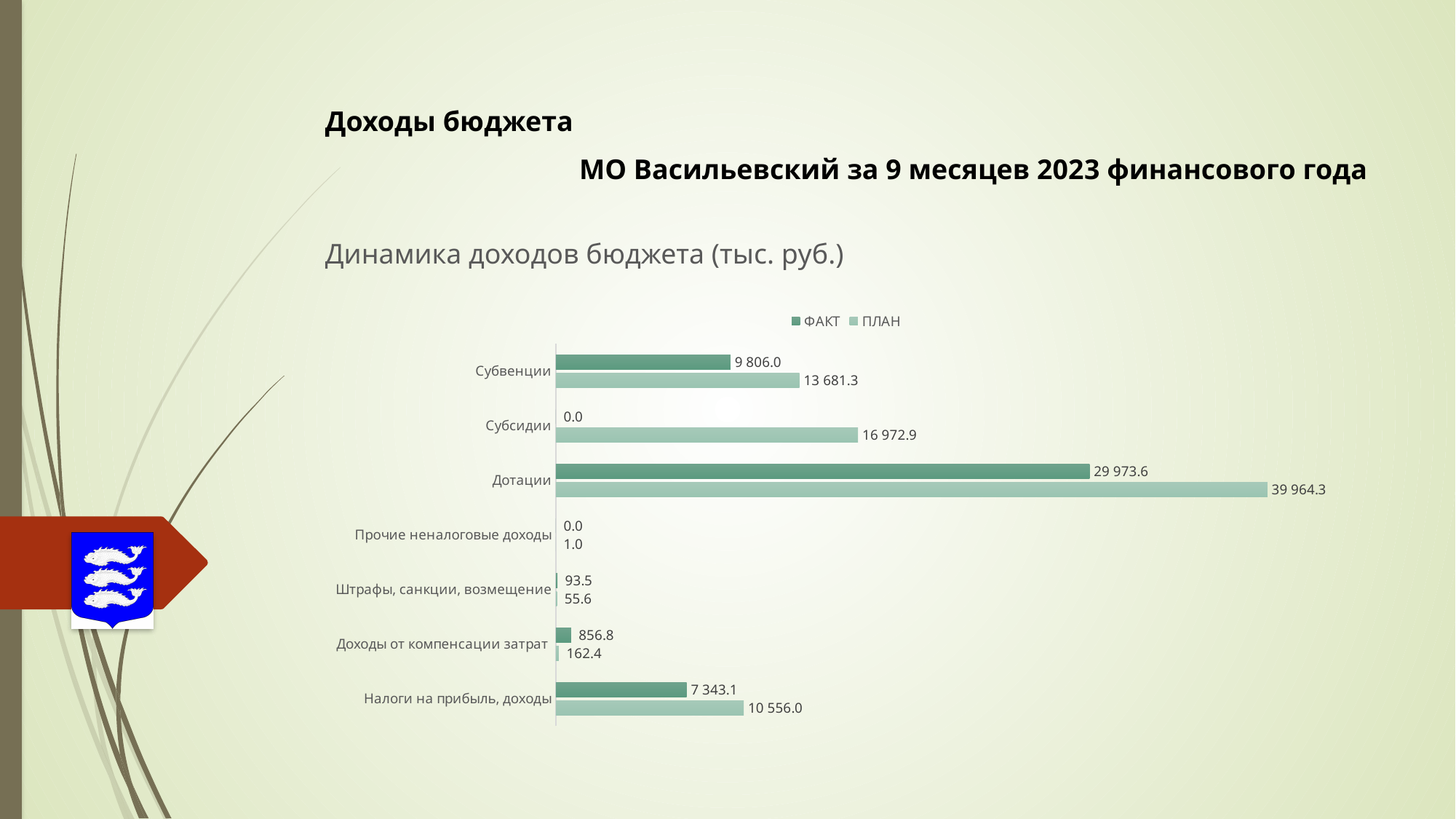
What is the difference between the ПЛАН and ФАКТ values for Субвенции? 3 875.3 What is the difference between the ПЛАН and ФАКТ values for Дотации? 9 990.7 What type of chart is shown on the slide? bar chart Which category has the highest ПЛАН value? Дотации For Доходы от компенсации затрат, which is larger: the ФАКТ value or the ПЛАН value? ФАКТ How many series does the legend list? 2 Which category has the lowest ПЛАН value? Прочие неналоговые доходы What is the ПЛАН value for Субсидии? 16 972.9 What is the ПЛАН value for Налоги на прибыль, доходы? 10 556.0 How many categories are shown on the chart? 7 What is the ФАКТ value for Дотации? 29 973.6 What is the title of the chart? Динамика доходов бюджета (тыс. руб.)